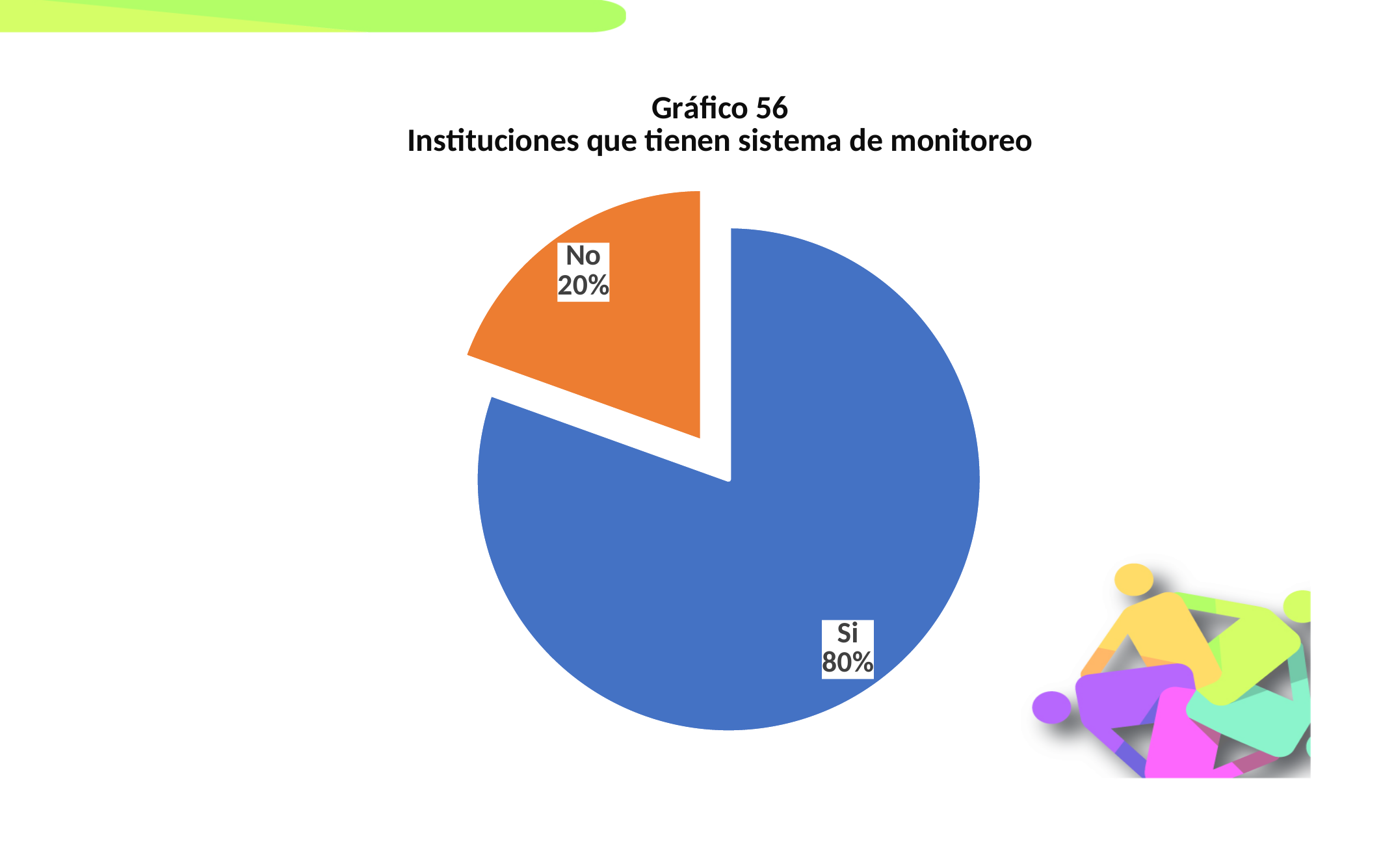
What colour is the "Si" slice? Blue What kind of chart is shown on the slide? Pie chart How many slices does the pie chart have? 2 What share of the pie does the "No" slice represent? 20% What is the value for the "Si" slice? 80% Which category has the largest share of the pie? Si What is the value for the "No" slice? 20% Which category has the smallest share of the pie? No What is the difference between the "Si" and "No" shares? 60% Which is larger, the "Si" slice or the "No" slice? Si What is the title of the chart? Gráfico 56 Instituciones que tienen sistema de monitoreo